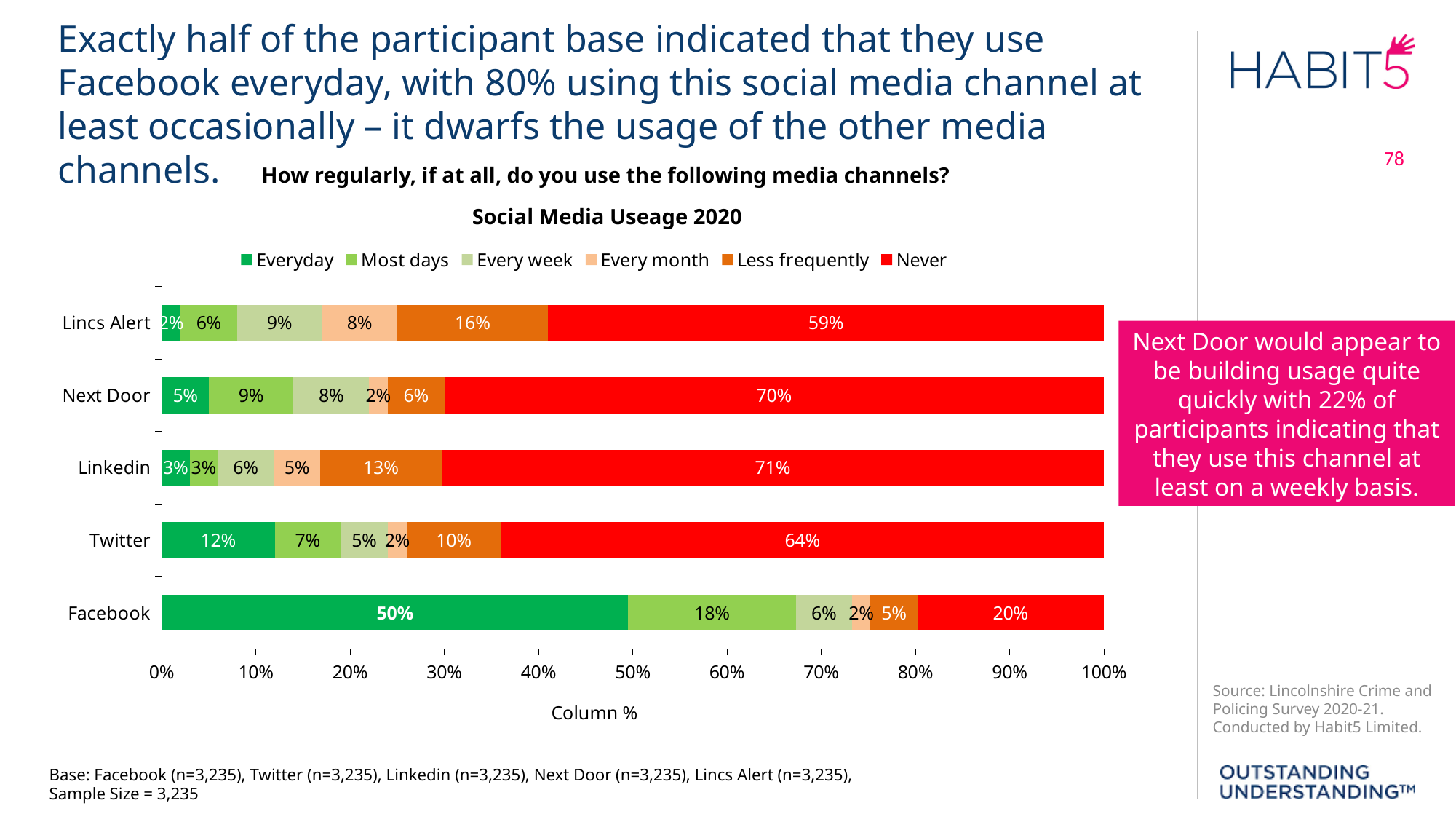
What is the Every week value for Next Door? 8% What is the difference between the Less frequently values for Lincs Alert and Linkedin? 3% What is the difference between the Everyday values for Facebook and Twitter? 38% How many series does the legend list? 6 Which has a larger Most days value, Next Door or Twitter? Next Door What type of chart is shown on the slide? Stacked bar chart What is the Less frequently value for Twitter? 10% What is the Never value for Lincs Alert? 59% Which media channel has the highest Everyday value? Facebook How many media channels are shown in the chart? 5 Which media channel has the lowest Everyday value? Lincs Alert What percentage of participants use Facebook Everyday? 50%